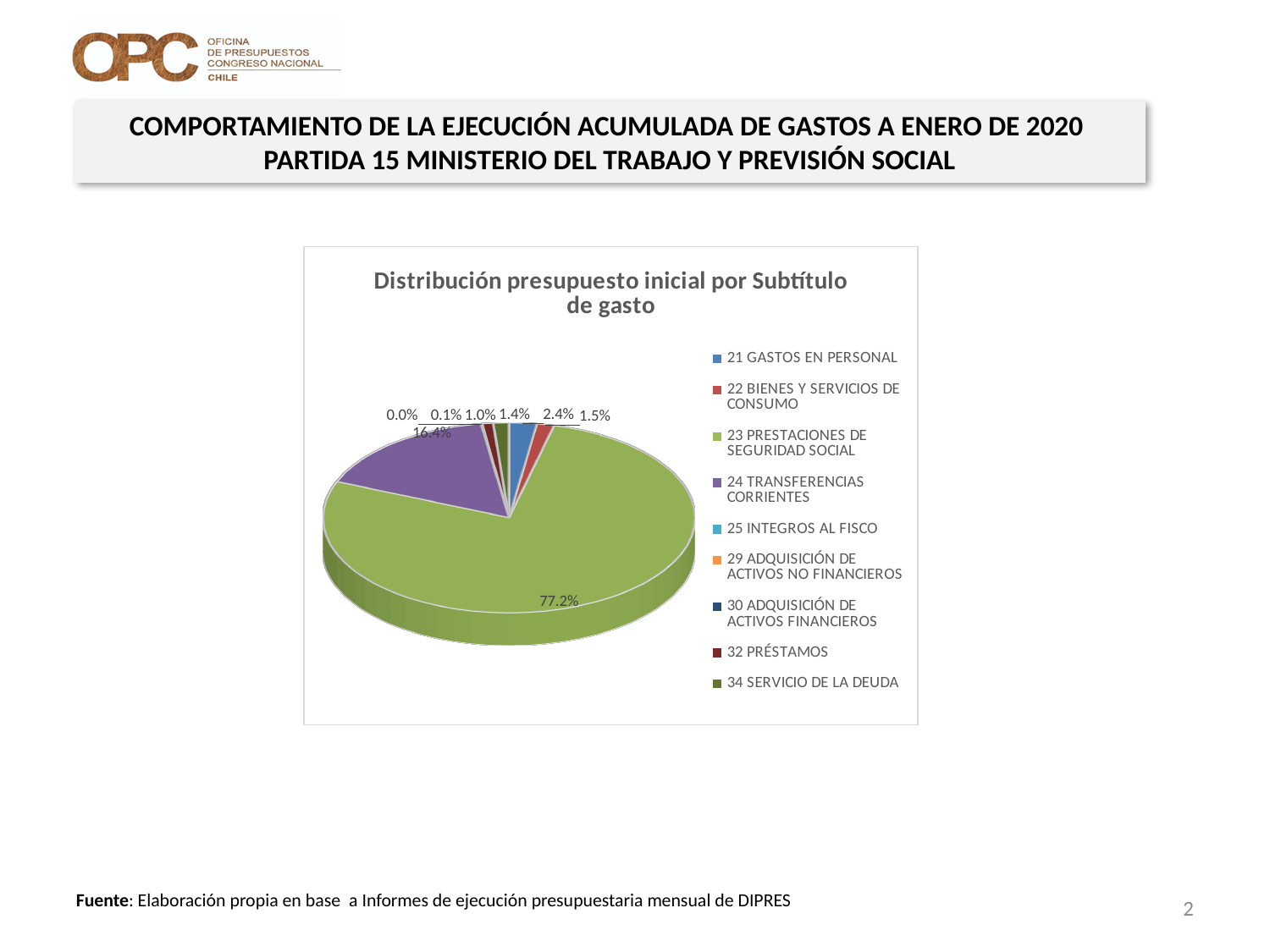
Which category has the largest slice of the pie? 23 PRESTACIONES DE SEGURIDAD SOCIAL How many categories does the chart's legend list? 9 What is the title of the chart? Distribución presupuesto inicial por Subtítulo de gasto What colour is the slice for 24 TRANSFERENCIAS CORRIENTES? Purple Is the share for 23 PRESTACIONES DE SEGURIDAD SOCIAL greater or less than 50%? greater Which is larger, the slice for 23 PRESTACIONES DE SEGURIDAD SOCIAL or the slice for 24 TRANSFERENCIAS CORRIENTES? 23 PRESTACIONES DE SEGURIDAD SOCIAL What kind of chart is shown on the slide? Pie chart What share of the pie does 23 PRESTACIONES DE SEGURIDAD SOCIAL represent? 77.2% What is the difference in percentage points between the slice for 23 PRESTACIONES DE SEGURIDAD SOCIAL and the slice for 24 TRANSFERENCIAS CORRIENTES? 60.8 percentage points What is the smallest percentage label shown on the pie chart? 0.0% What share of the pie does 24 TRANSFERENCIAS CORRIENTES represent? 16.4%